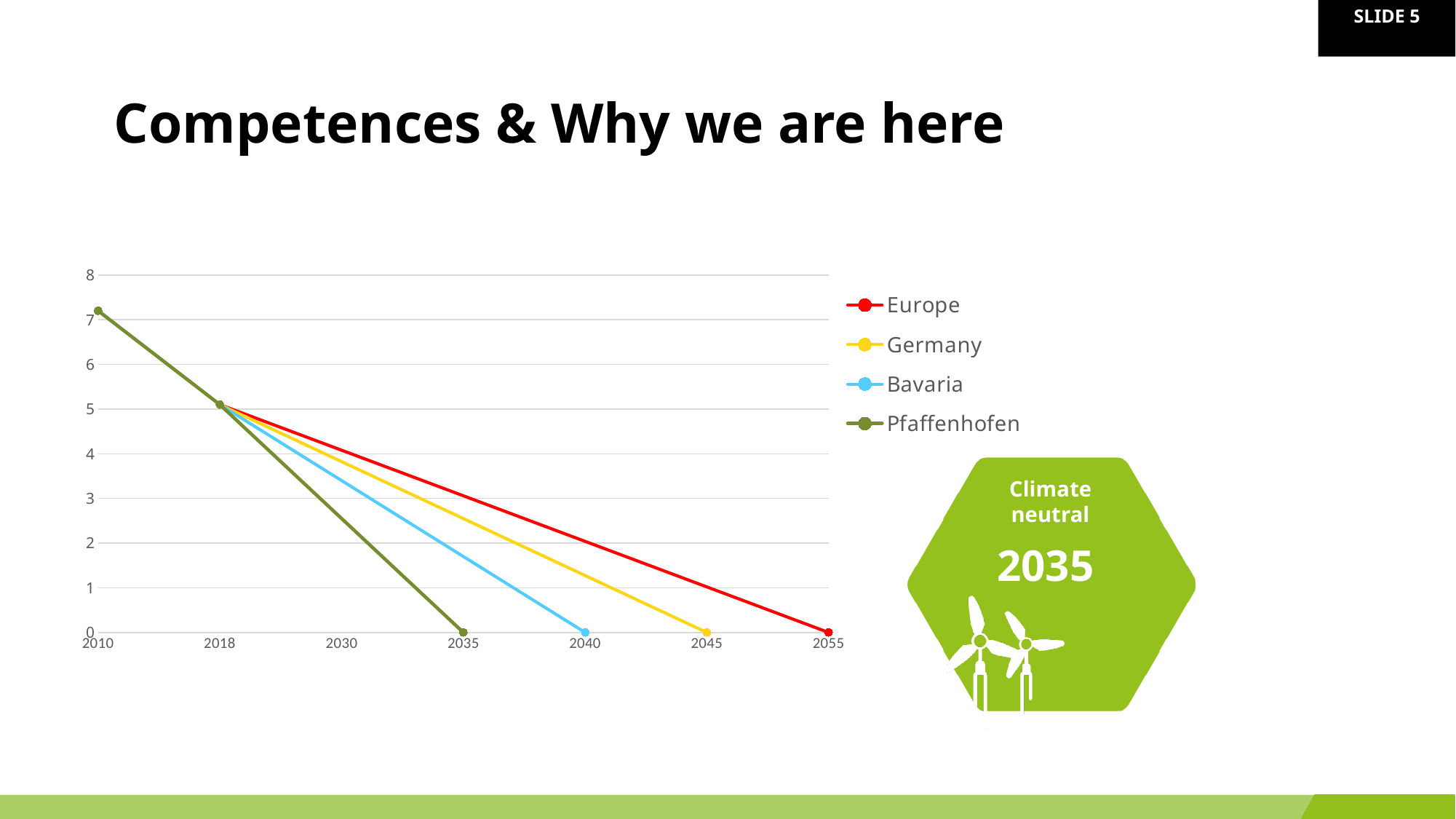
In which year does the Europe line reach 0? 2055 In which year does the Bavaria line reach 0? 2040 Which series reaches 0 first (earliest year)? Pfaffenhofen Is the value of the lines in 2010 greater or less than 7? greater In which year does the Germany line reach 0? 2045 What colour is the Europe line in the legend? red Do the lines rise or fall from 2010 onwards? fall In 2030, which series has the higher value, Europe or Pfaffenhofen? Europe How many series does the legend list? 4 What kind of chart is shown on the slide? line chart Which series reaches 0 last (latest year)? Europe In which year does the Pfaffenhofen line reach 0? 2035